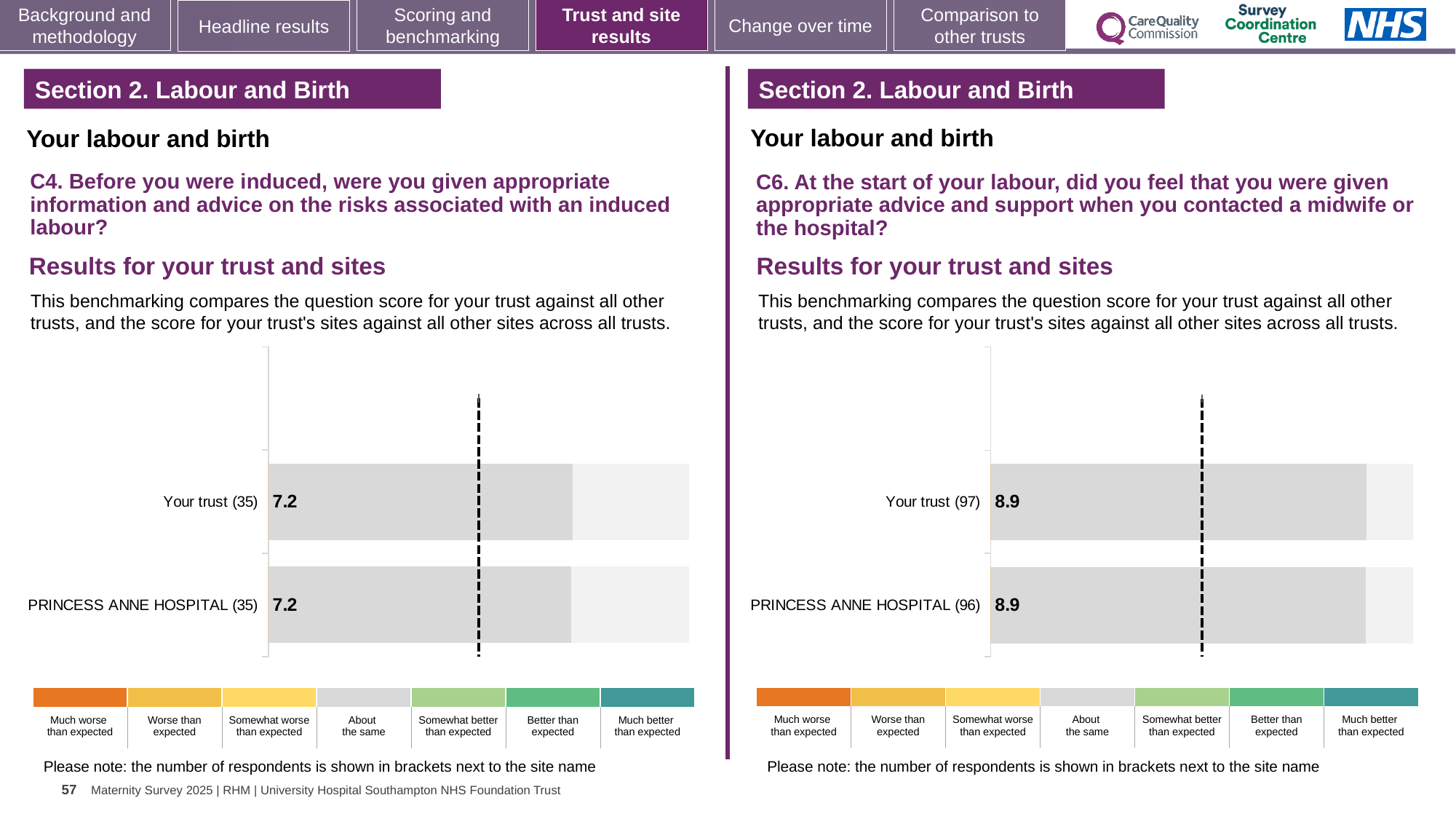
On the right chart (C6), what is the difference between the score for Your trust and the score for PRINCESS ANNE HOSPITAL? 0 Is the score for Your trust on the right chart (C6) larger or smaller than the score for Your trust on the left chart (C4)? Larger On the left chart (C4), what is the score for Your trust? 7.2 On the left chart (C4), what is the score for PRINCESS ANNE HOSPITAL? 7.2 On the right chart (C6), how many respondents are shown in brackets for PRINCESS ANNE HOSPITAL? 96 What kind of chart is used on the left (C4)? Bar chart How many bars are plotted on the left chart (C4)? 2 On the right chart (C6), what is the score for PRINCESS ANNE HOSPITAL? 8.9 On the left chart (C4), how many respondents are shown in brackets for Your trust? 35 On the left chart (C4), what is the difference between the score for Your trust and the score for PRINCESS ANNE HOSPITAL? 0 On the right chart (C6), what is the score for Your trust? 8.9 How many bars are plotted on the right chart (C6)? 2